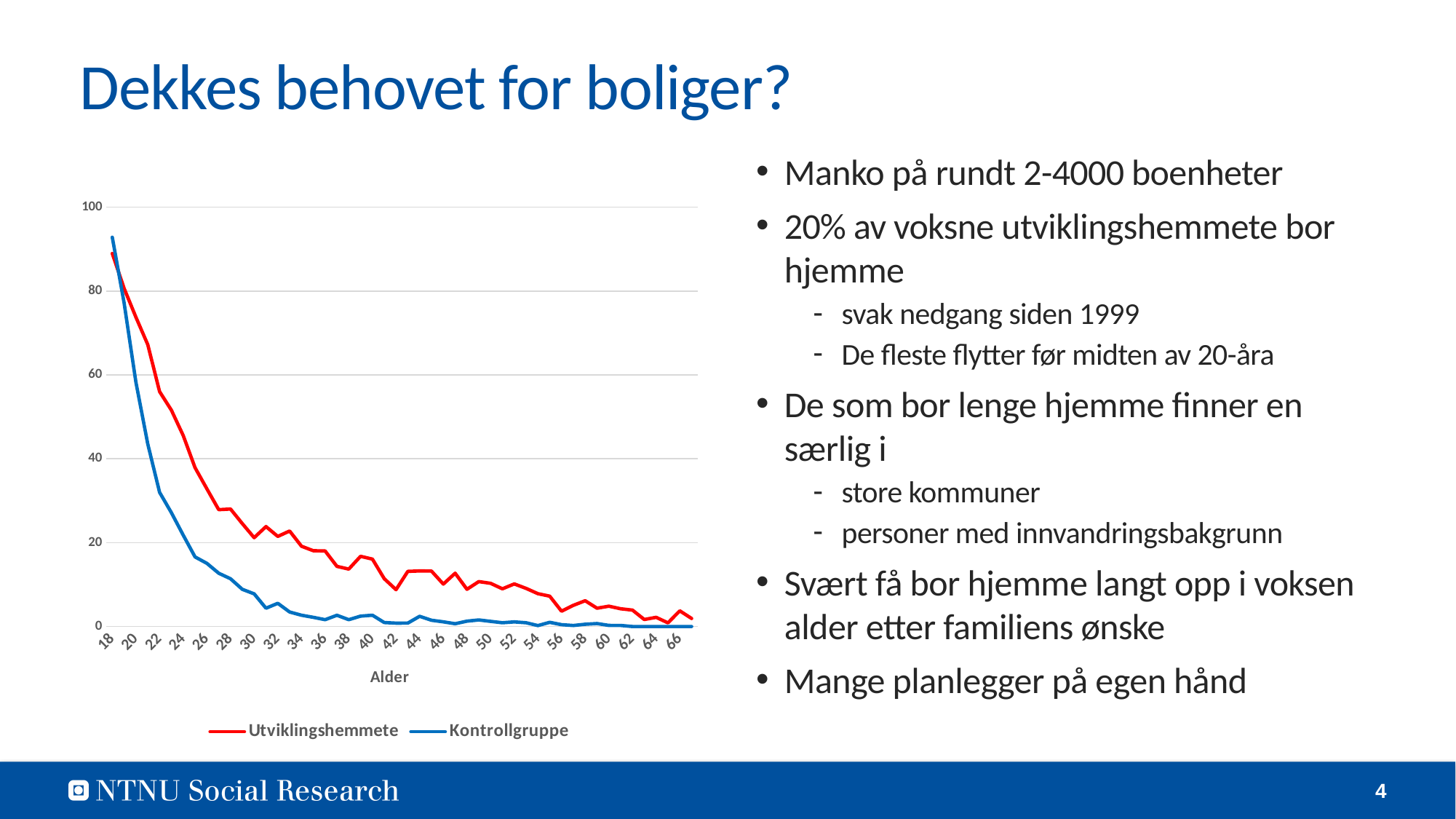
Is the value for Utviklingshemmete at age 18 greater or less than 80? greater At age 30, which series has the higher value, Utviklingshemmete or Kontrollgruppe? Utviklingshemmete Do the values for Utviklingshemmete rise or fall as age increases along the x axis? fall What is the title of the chart's x axis? Alder What are the two series named in the chart's legend? Utviklingshemmete and Kontrollgruppe Do the values for Kontrollgruppe rise or fall as age increases along the x axis? fall Is the value for Kontrollgruppe at age 30 greater or less than 20? less Is the value for Kontrollgruppe at age 22 greater or less than 40? less How many age labels are shown on the chart's x axis? 25 How many series does the chart's legend list? 2 What kind of chart is shown on the slide? line chart